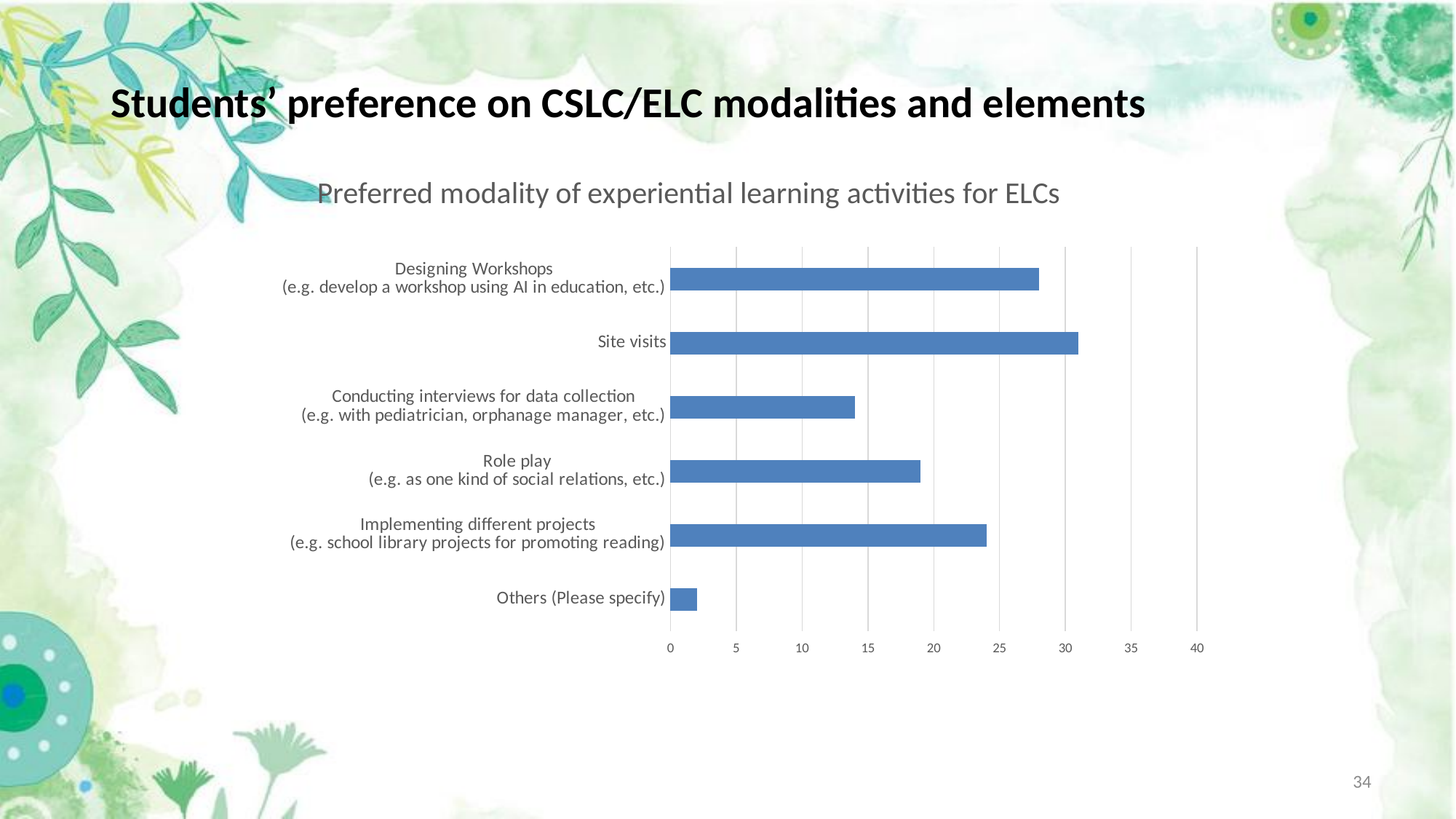
Is the value for Others (Please specify) greater or less than 5? less Is the value for Conducting interviews for data collection greater or less than 10? greater What is the title of the chart? Preferred modality of experiential learning activities for ELCs Is the value for Implementing different projects greater or less than 20? greater Which is larger, the value for Role play or the value for Implementing different projects? Implementing different projects What type of chart is shown on the slide? bar chart How many categories are shown in the chart? 6 Which category has the lowest value? Others (Please specify) Which category has the highest value? Site visits